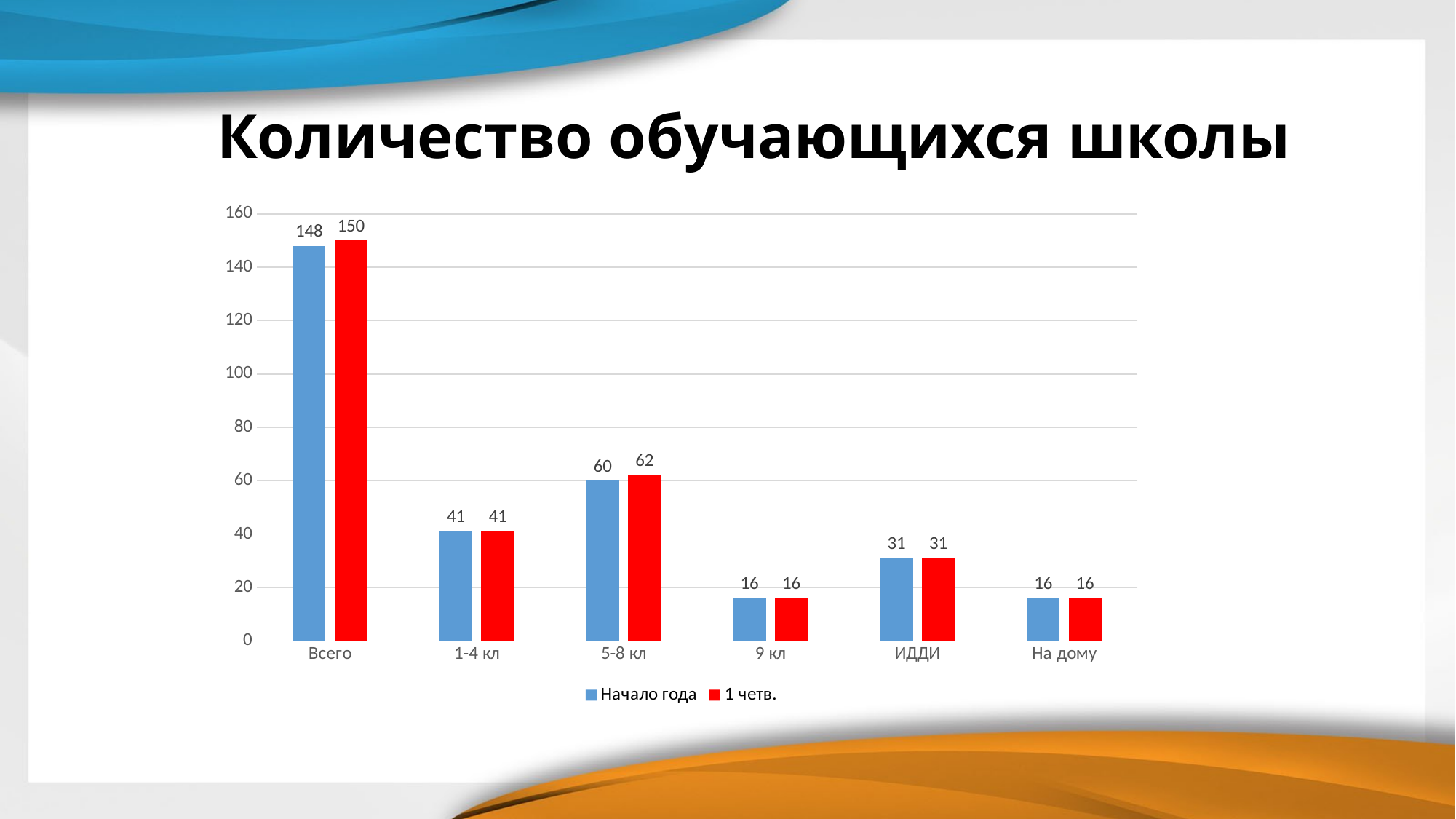
Which category has the lowest value in the Начало года series, 1-4 кл or 5-8 кл? 1-4 кл What is the value for ИДДИ in the Начало года series? 31 Which is larger for 5-8 кл: the Начало года value or the 1 четв. value? 1 четв. Which category has the highest value in the 1 четв. series? Всего What is the difference between the 5-8 кл and 1-4 кл values in the Начало года series? 19 How many categories are shown on the x axis? 6 What is the value for Всего in the Начало года series? 148 What is the value for 5-8 кл in the 1 четв. series? 62 How many series does the legend list? 2 What is the difference between the 1 четв. and Начало года values for Всего? 2 What kind of chart is shown on the slide? Bar chart What is the title of the chart on the slide? Количество обучающихся школы